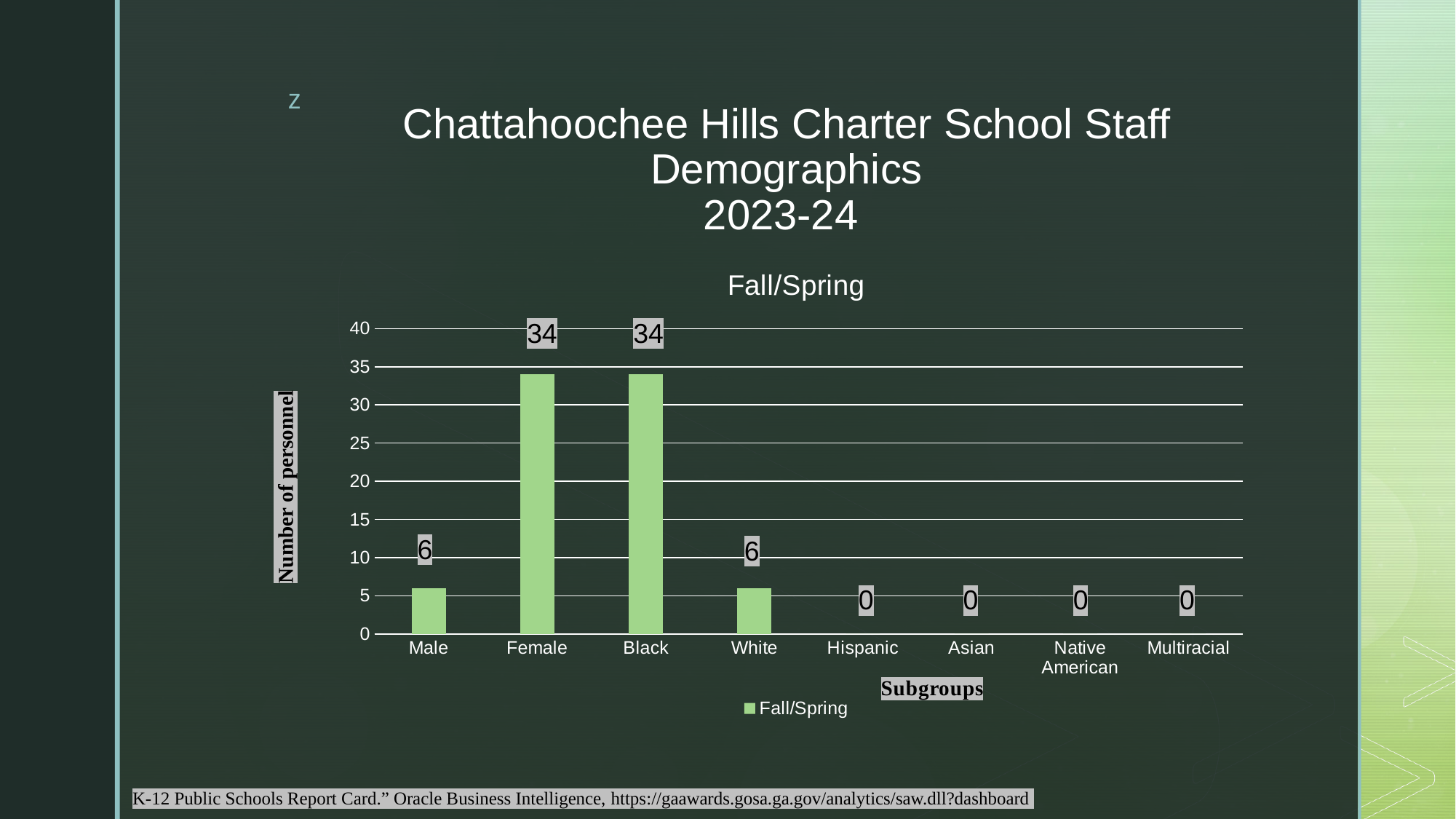
What is the value for White? 6 How many series does the legend list? 1 What is the value for Female? 34 What is the value for Hispanic? 0 What is the value for Male? 6 What is the title of the chart? Fall/Spring Is the value for Female greater or less than 30? greater What is the difference between the values for Female and Male? 28 How many subgroups are shown on the x axis? 8 Which is larger, the value for Black or the value for White? Black What is the difference between the values for Black and White? 28 What kind of chart is shown? bar chart